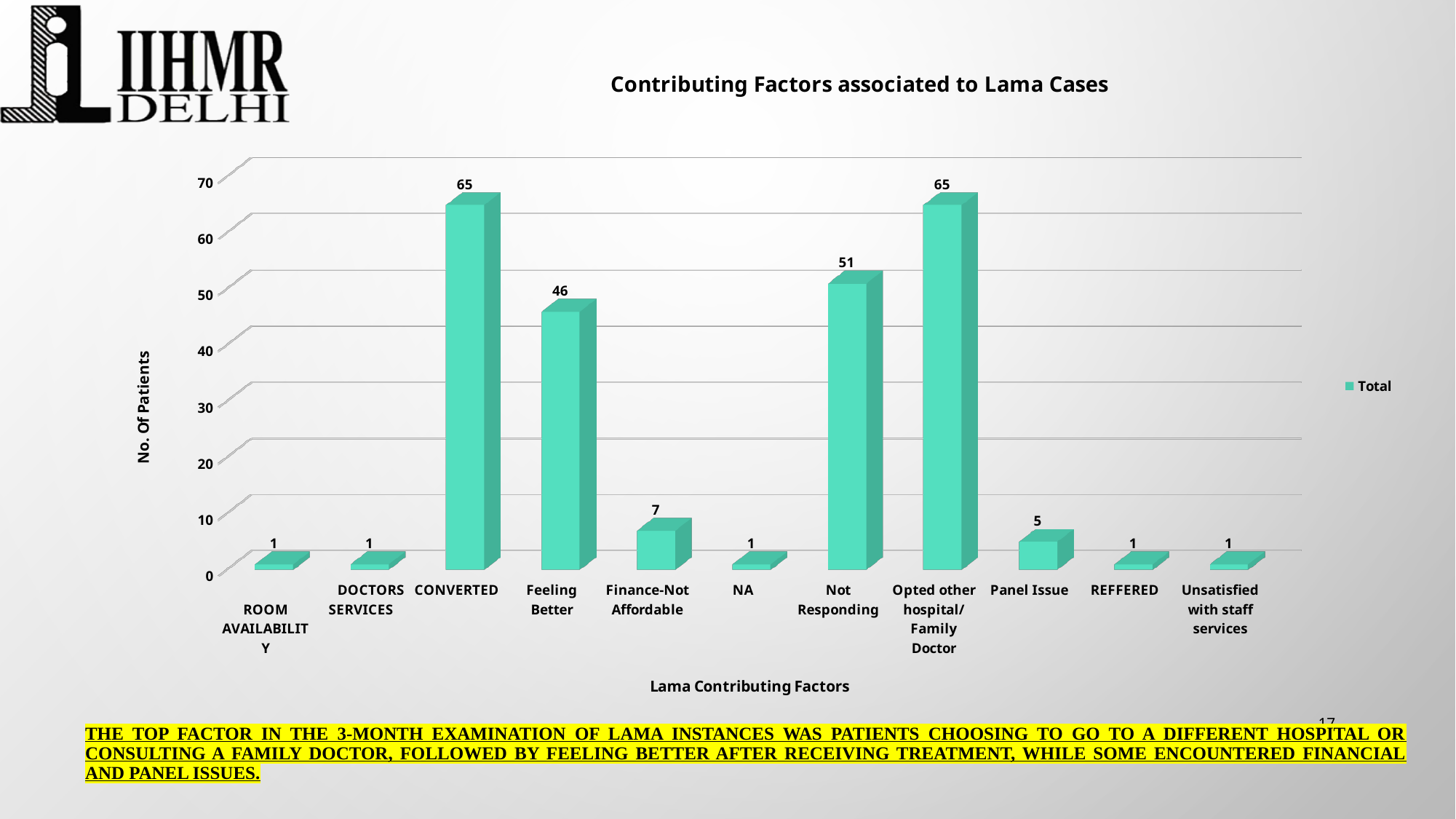
What is the value for Not Responding? 51 What is the value for Feeling Better? 46 How many categories are shown on the x axis? 11 What is the difference between the values for CONVERTED and Feeling Better? 19 Which is larger, the value for Not Responding or the value for Feeling Better? Not Responding What is the value for Panel Issue? 5 What is the title of the chart? Contributing Factors associated to Lama Cases What is the value for Finance-Not Affordable? 7 What kind of chart is shown on the slide? Bar chart What is the difference between the values for Not Responding and Panel Issue? 46 What is the value for CONVERTED? 65 How many series does the legend list? 1